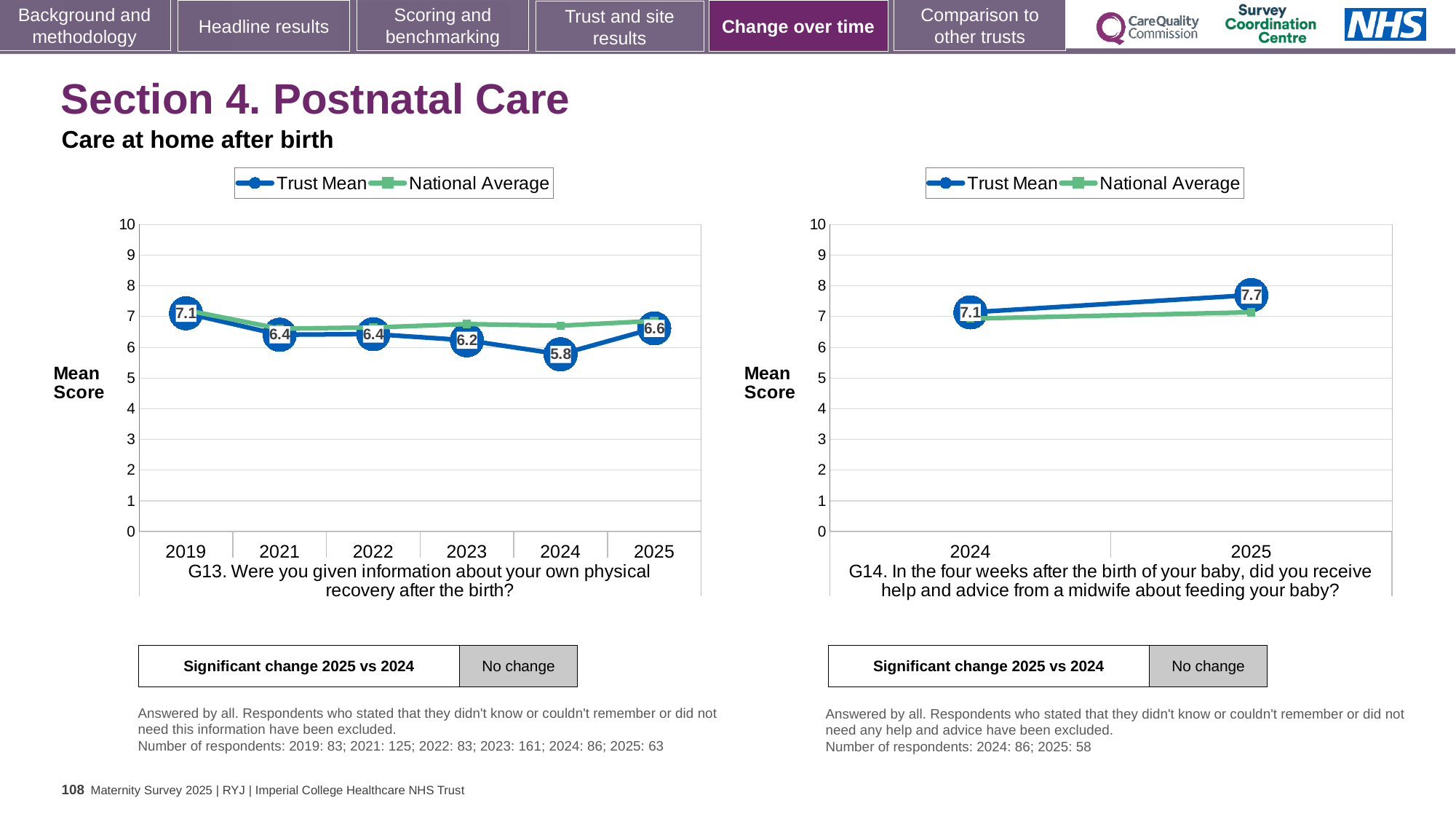
In the G14 chart, what is the difference between the Trust Mean for 2025 and 2024? 0.6 In the G13 chart, what is the difference between the Trust Mean for 2025 and 2024? 0.8 In the G13 chart, which year has the lowest Trust Mean? 2024 In the G13 chart, what is the Trust Mean for 2024? 5.8 In the G14 chart, does the Trust Mean rise or fall from 2024 to 2025? rise In the G13 chart, how many years are shown on the x axis? 6 In the G13 chart, is the National Average for 2024 greater or less than 6? greater In the G13 chart, what is the Trust Mean for 2019? 7.1 In the G14 chart, what is the Trust Mean for 2025? 7.7 What kind of chart is the G13 chart? line chart How many series does the legend of the G14 chart list? 2 In the G13 chart, which year has the highest Trust Mean? 2019